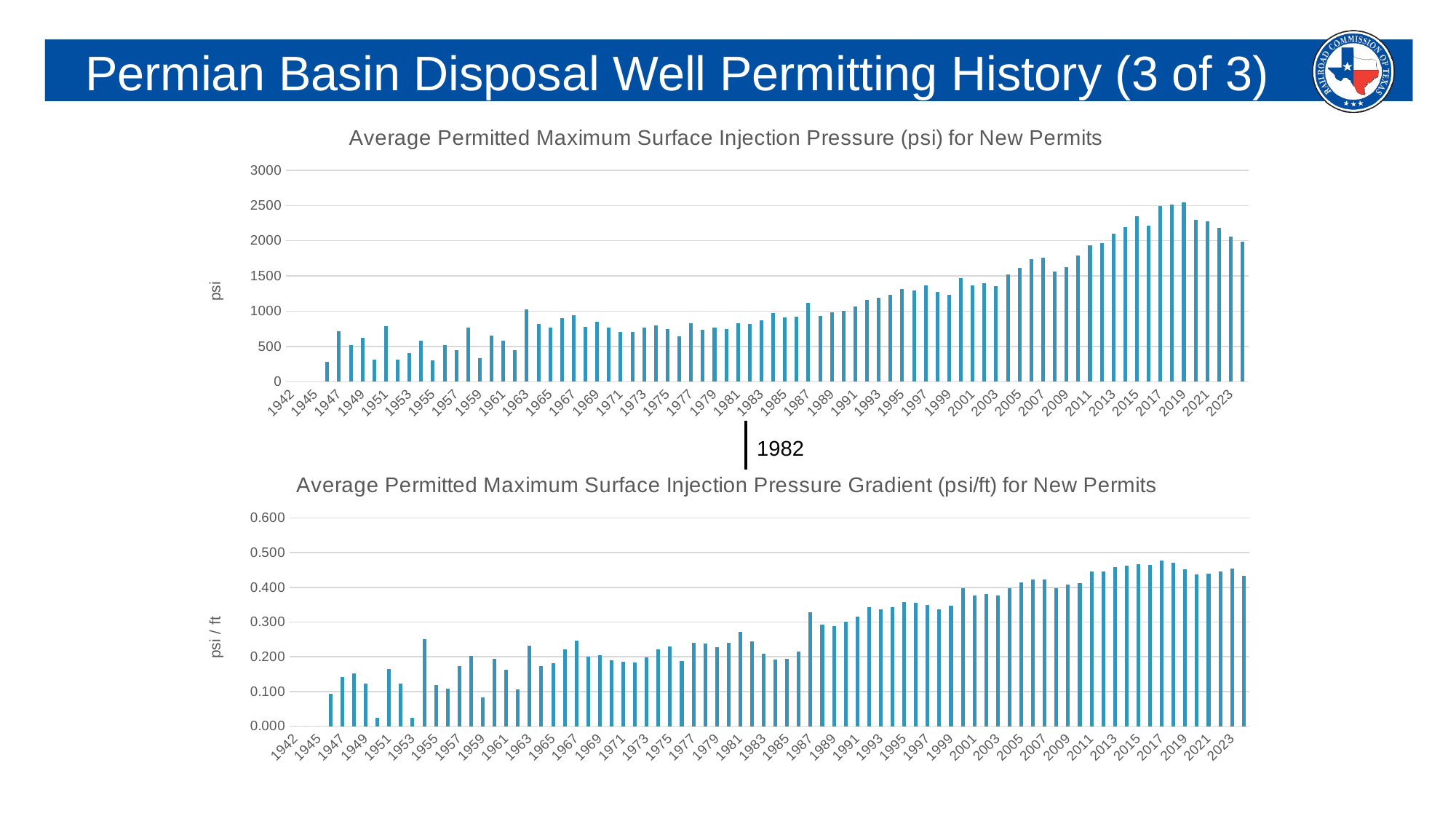
What is the y-axis label of the bottom chart? psi / ft In the top chart (psi), is the value for 2019 greater or less than 2000? greater In the top chart (psi), which year has the highest average permitted maximum surface injection pressure? 2019 In the bottom chart (psi/ft), is the value for 1987 greater or less than 0.300? greater In the bottom chart (psi/ft), which is larger, the value for 2017 or the value for 1953? 2017 In the top chart (psi), do the values generally rise or fall from 1945 to 2019? rise In the bottom chart (psi/ft), is the value for 2017 greater or less than 0.400? greater What kind of chart is the top chart, 'Average Permitted Maximum Surface Injection Pressure (psi) for New Permits'? bar chart